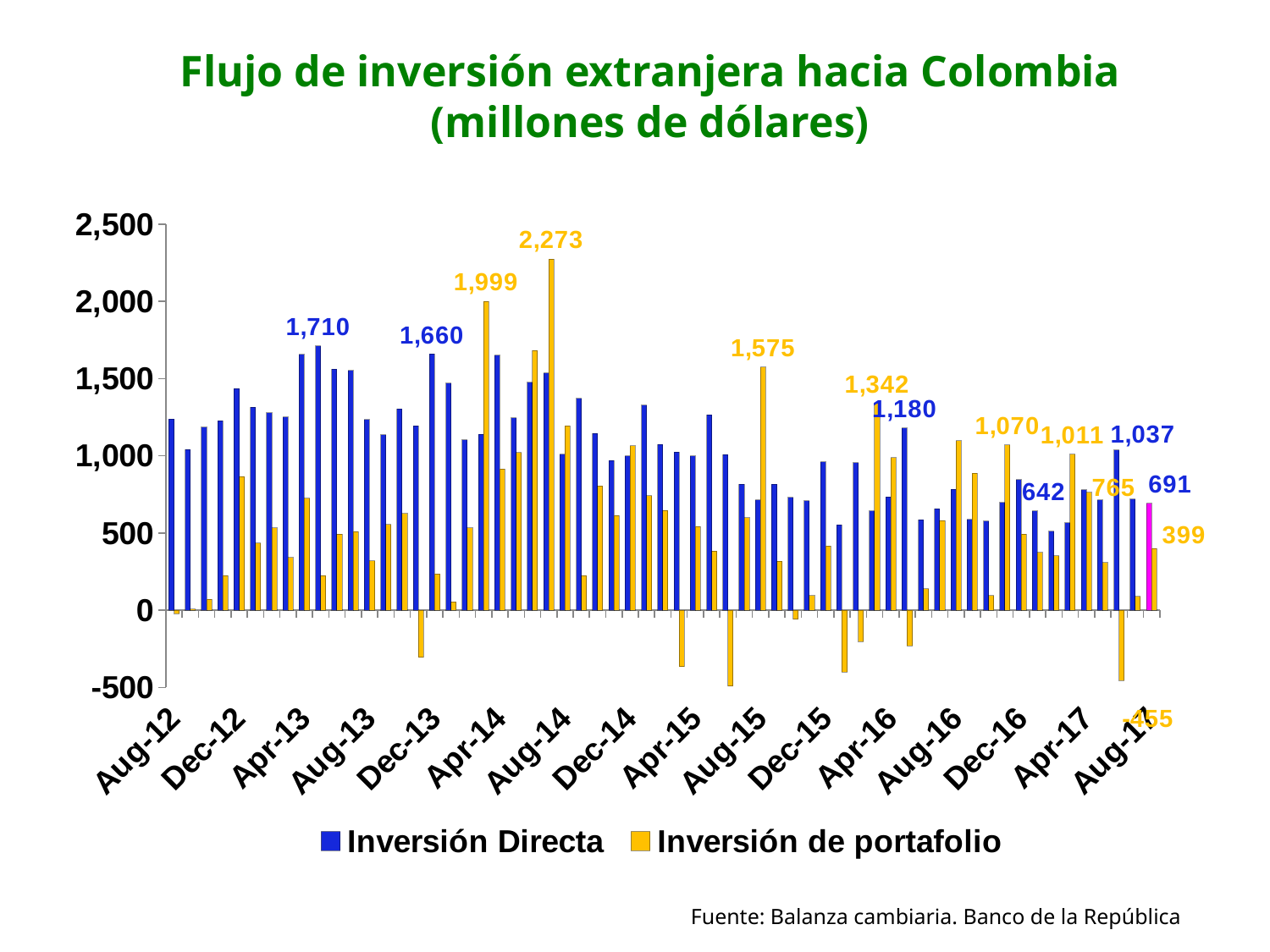
What is the difference between the highest labelled Inversión de portafolio value (2,273) and the highest labelled Inversión Directa value (1,710)? 563 What is the value of Inversión de portafolio for Aug-17, the last month on the chart? 399 What is the lowest labelled value for Inversión de portafolio? -455 How many series does the legend list? 2 What is the value of Inversión Directa for Aug-17, the last month on the chart? 691 What kind of chart is shown on the slide? bar chart What are the two series named in the legend? Inversión Directa and Inversión de portafolio For Aug-17, which is larger: Inversión Directa or Inversión de portafolio? Inversión Directa What is the difference between Inversión Directa and Inversión de portafolio in Aug-17? 292 What is the title of the chart? Flujo de inversión extranjera hacia Colombia (millones de dólares) What is the highest labelled value for Inversión Directa? 1,710 What is the highest labelled value for Inversión de portafolio? 2,273